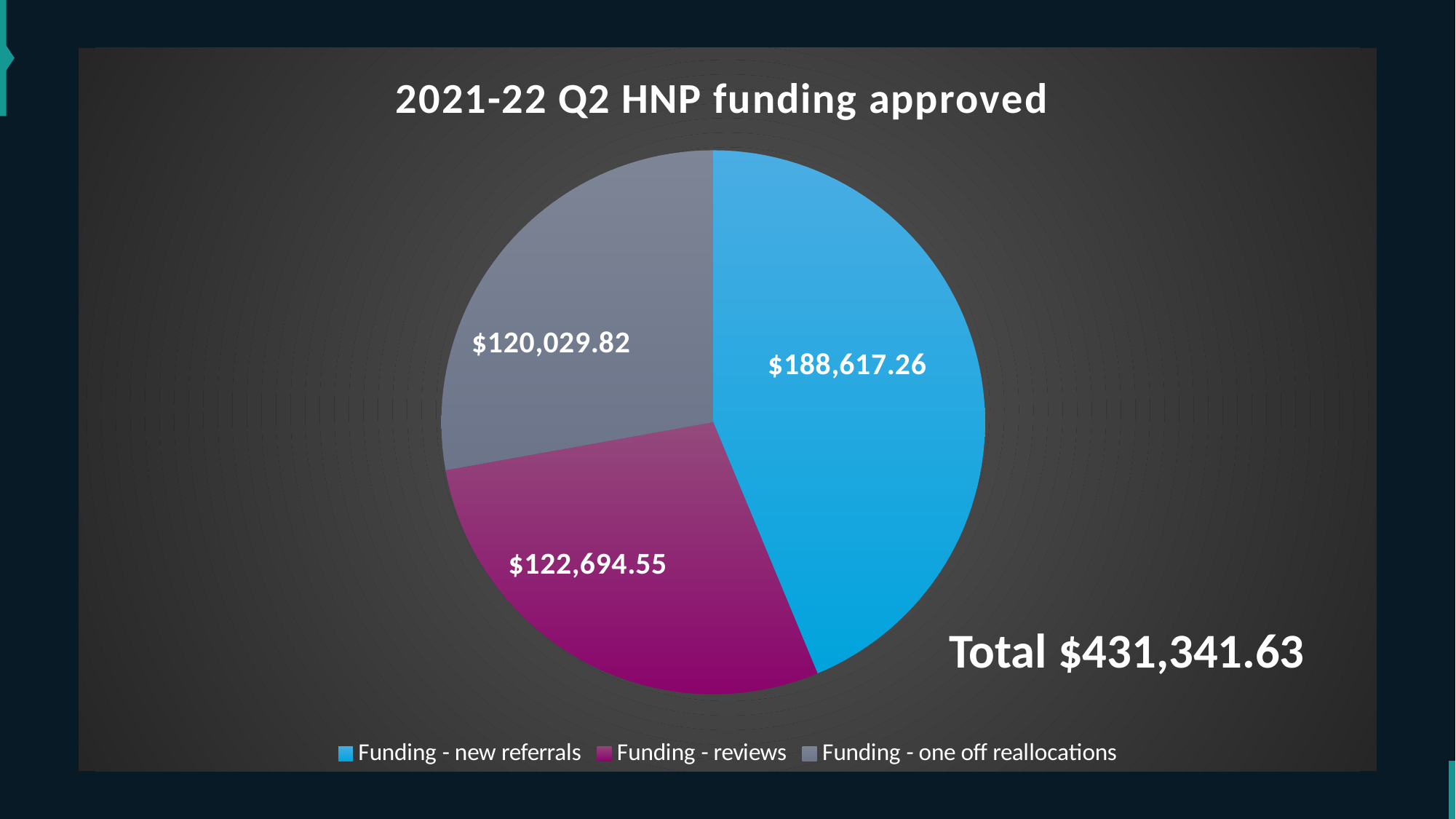
What is the difference between Funding - new referrals and Funding - reviews? $65,922.71 What type of chart is shown on the slide? Pie chart What is the title of the chart? 2021-22 Q2 HNP funding approved What is the value for Funding - new referrals? $188,617.26 What total funding amount is shown on the slide? $431,341.63 What is the value for Funding - one off reallocations? $120,029.82 What is the value for Funding - reviews? $122,694.55 Which category has the largest slice of the pie? Funding - new referrals Which is larger, Funding - reviews or Funding - one off reallocations? Funding - reviews Which category has the smallest slice of the pie? Funding - one off reallocations How many categories does the legend list? 3 What is the difference between Funding - reviews and Funding - one off reallocations? $2,664.73